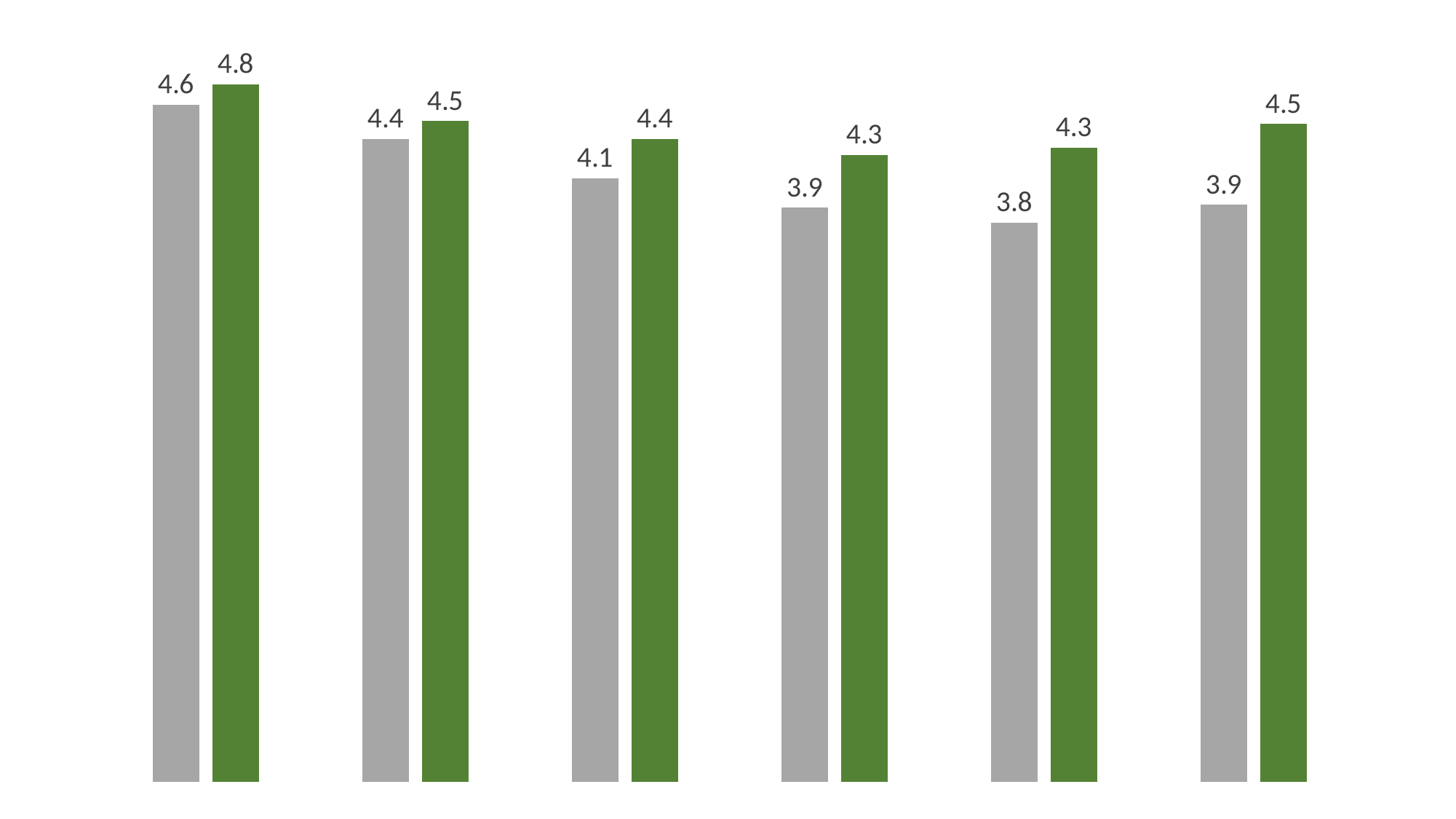
What two colours are used for the bars in the chart? grey and green How many groups of bars are shown in the chart? 6 What kind of chart is shown on the slide? bar chart Which group has the lowest grey bar? the fifth group from the left What is the value of the grey bar in the fifth group from the left? 3.8 What is the value of the green bar in the first (leftmost) group? 4.8 In the fifth group from the left, which bar is larger, the grey or the green? green What is the difference between the green and grey bars in the sixth (rightmost) group? 0.6 What is the difference between the green and grey bars in the second group from the left? 0.1 What is the value of the green bar in the fourth group from the left? 4.3 Which group has the highest green bar? the first (leftmost) group What is the value of the grey bar in the third group from the left? 4.1